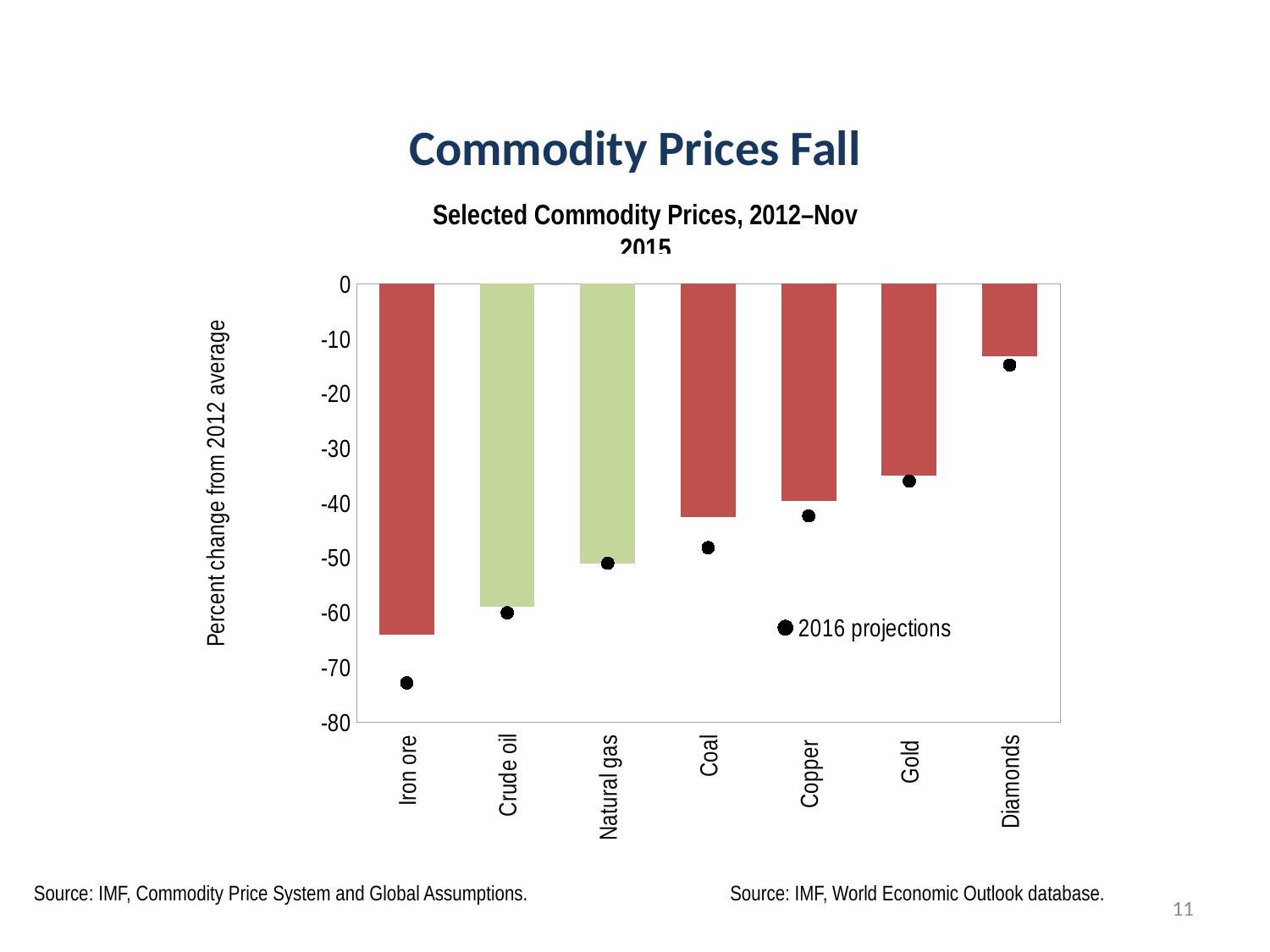
What does the black dot marker in the chart's legend represent? 2016 projections Is the 2016 projection dot for Iron ore greater or less than -70? less Which commodity has the highest (least negative) bar value in the chart? Diamonds Is the bar value for Iron ore greater or less than -60? less Which commodity has the lowest (most negative) bar value in the chart? Iron ore Is the bar value for Crude oil greater or less than -50? less Do the bar values rise or fall moving from Iron ore to Diamonds along the x axis? rise What kind of chart is shown on the slide? Bar chart Which has the higher (less negative) bar value, Coal or Gold? Gold How many commodities are shown on the x axis of the chart? 7